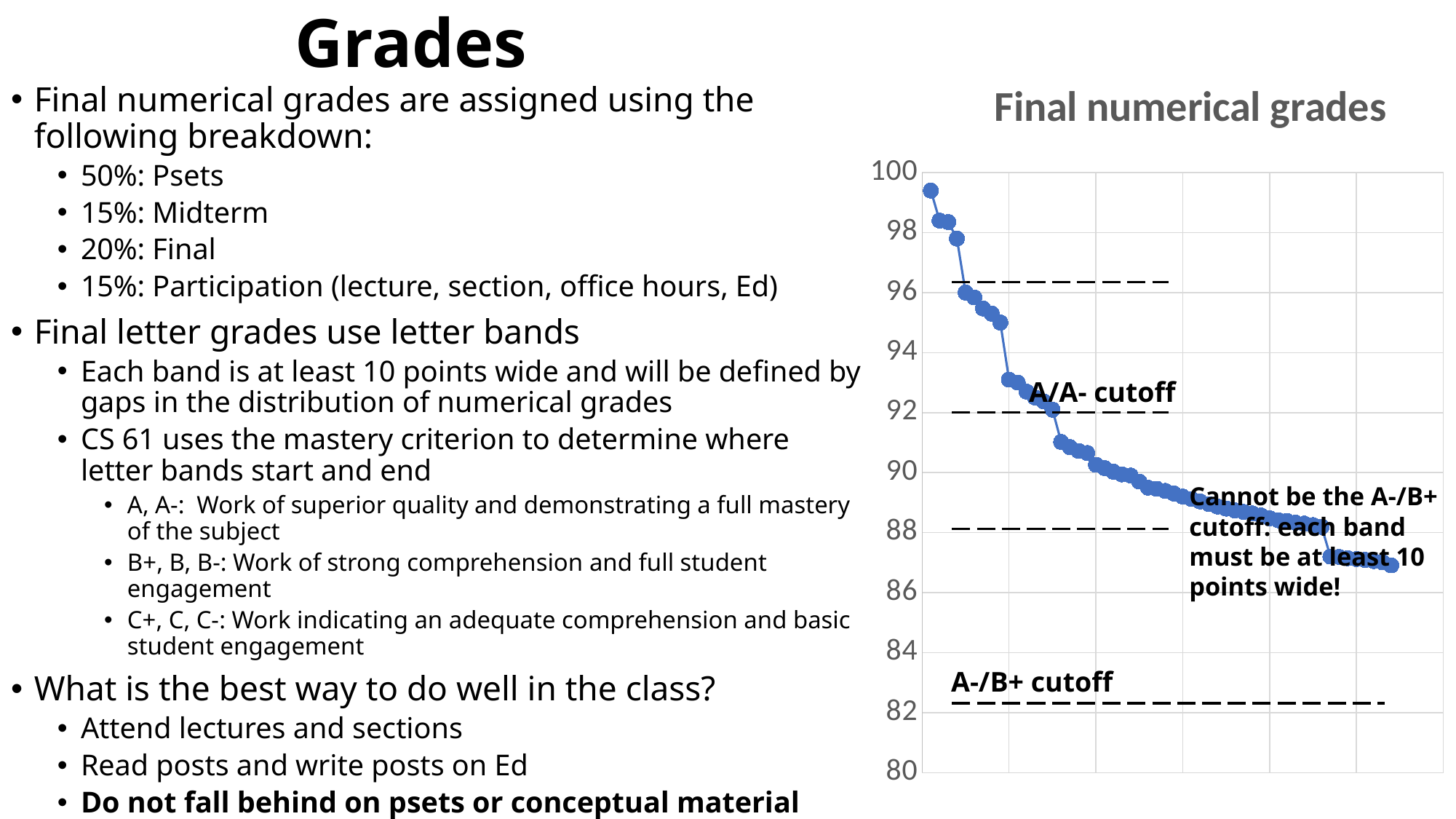
Which of the two labelled cutoff lines is drawn higher on the chart, the "A/A- cutoff" or the "A-/B+ cutoff"? A/A- cutoff Do the plotted grades rise or fall from left to right along the x axis? Fall Is the lowest plotted grade greater or less than 88? less What is the lowest value shown on the chart's vertical axis? 80 What kind of chart is shown under the title "Final numerical grades"? Line chart with markers (scatter) What is the title of the chart on the right side of the slide? Final numerical grades Is the highest plotted grade greater or less than 98? greater Is the first plotted grade greater or less than 100? less